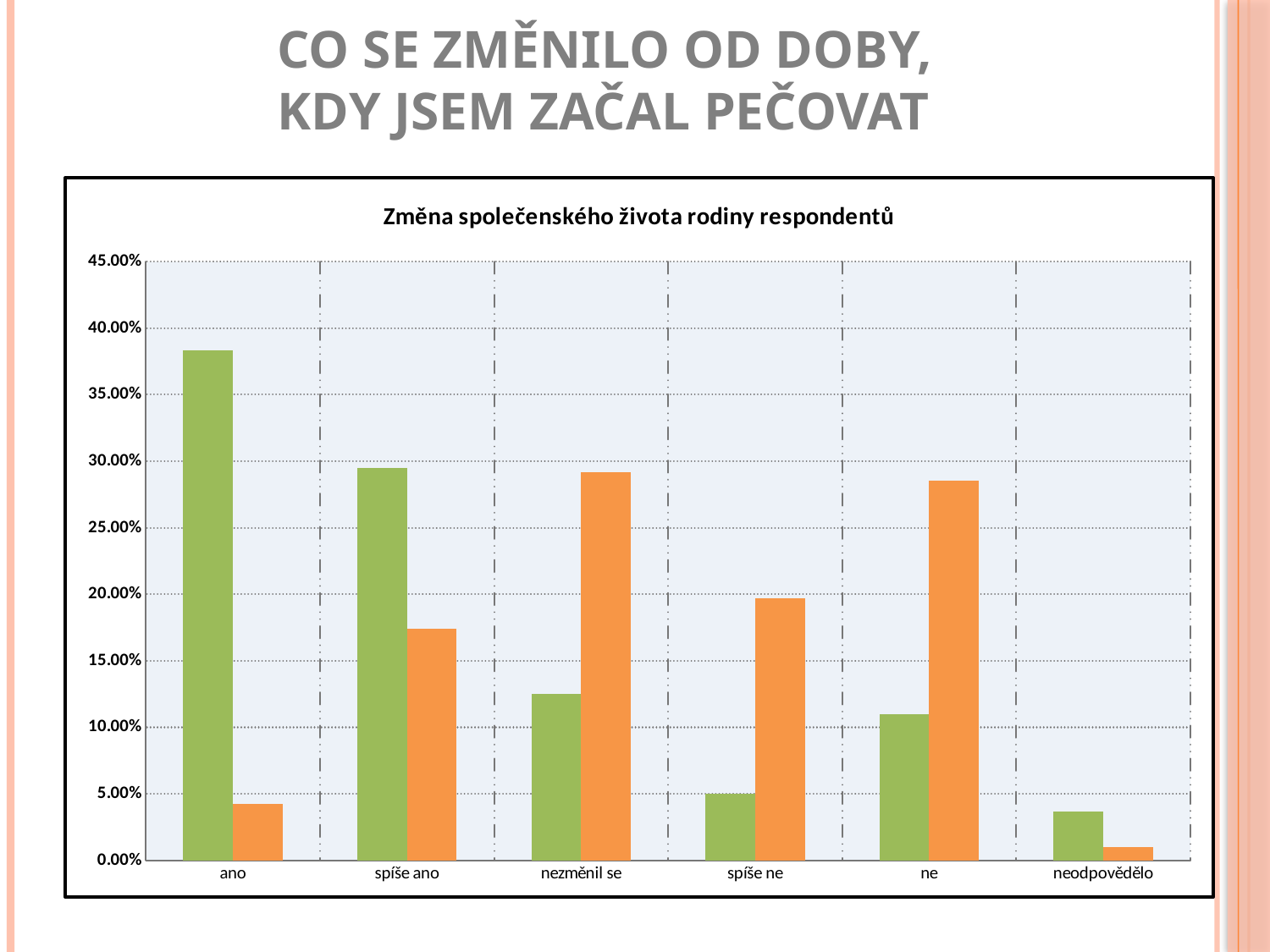
Is the green bar for 'ano' greater or less than 35.00%? greater Is the orange bar for 'ano' greater or less than 5.00%? less For the category 'ano', which bar is taller, the green one or the orange one? green What is the title of the chart? Změna společenského života rodiny respondentů Which category has the shortest orange bar? neodpovědělo How many categories are shown on the x axis of the chart? 6 Is the orange bar for 'ne' greater or less than 25.00%? greater For the category 'ne', which bar is taller, the green one or the orange one? orange Which category has the tallest green bar? ano What kind of chart is shown on the slide? bar chart